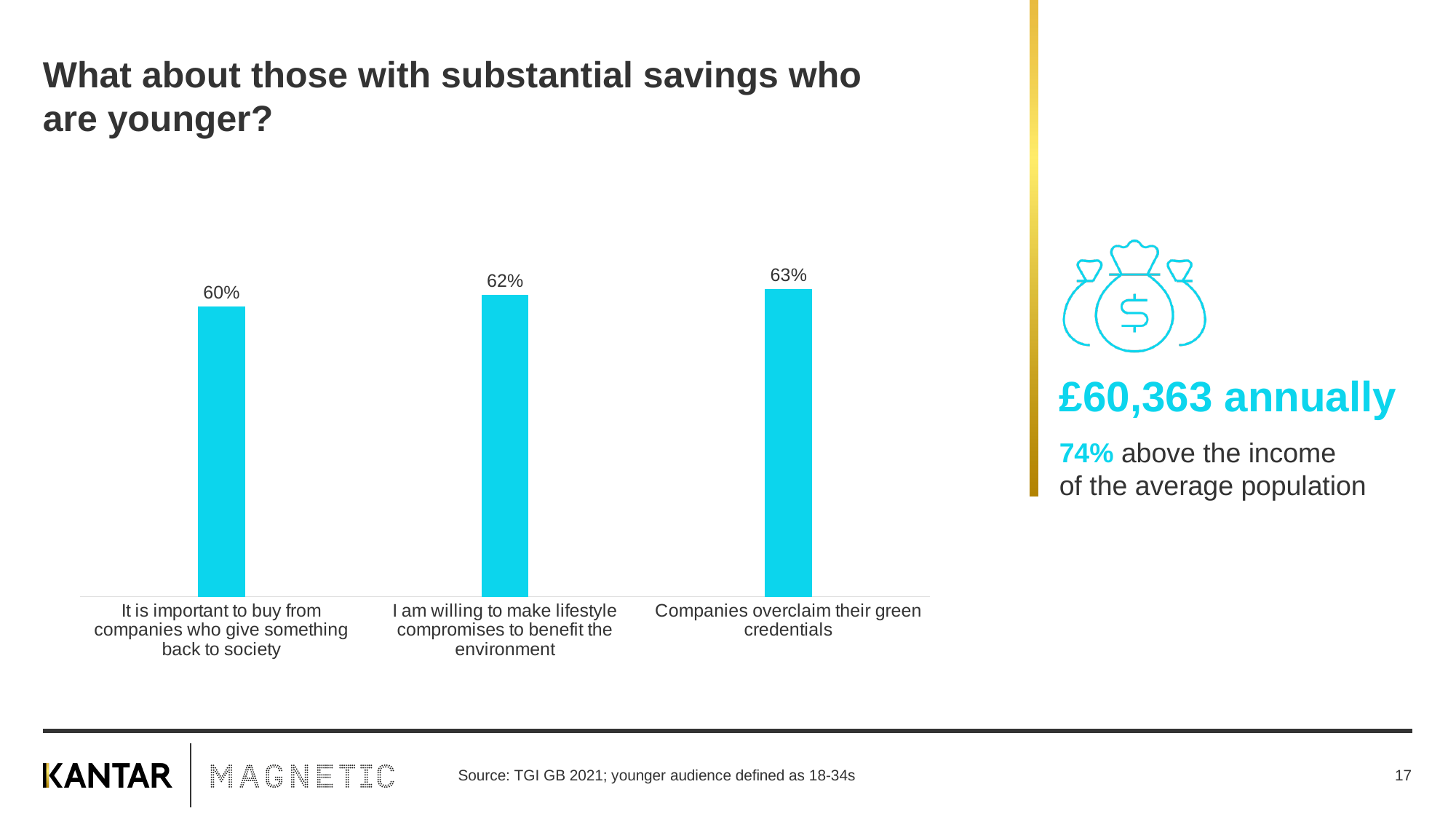
What is the value for "Companies overclaim their green credentials"? 63% Do the values rise or fall from left to right across the categories? Rise Which is larger: the value for "Companies overclaim their green credentials" or the value for "I am willing to make lifestyle compromises to benefit the environment"? Companies overclaim their green credentials Which category has the lowest value? It is important to buy from companies who give something back to society How many categories are shown in the chart? 3 What is the difference between the values for "I am willing to make lifestyle compromises to benefit the environment" and "It is important to buy from companies who give something back to society"? 2% What is the difference between the values for "Companies overclaim their green credentials" and "It is important to buy from companies who give something back to society"? 3% Which category has the highest value? Companies overclaim their green credentials What colour are the bars in the chart? Cyan (light blue) What is the value for "I am willing to make lifestyle compromises to benefit the environment"? 62% What kind of chart is shown on the slide? Bar chart What is the value for "It is important to buy from companies who give something back to society"? 60%